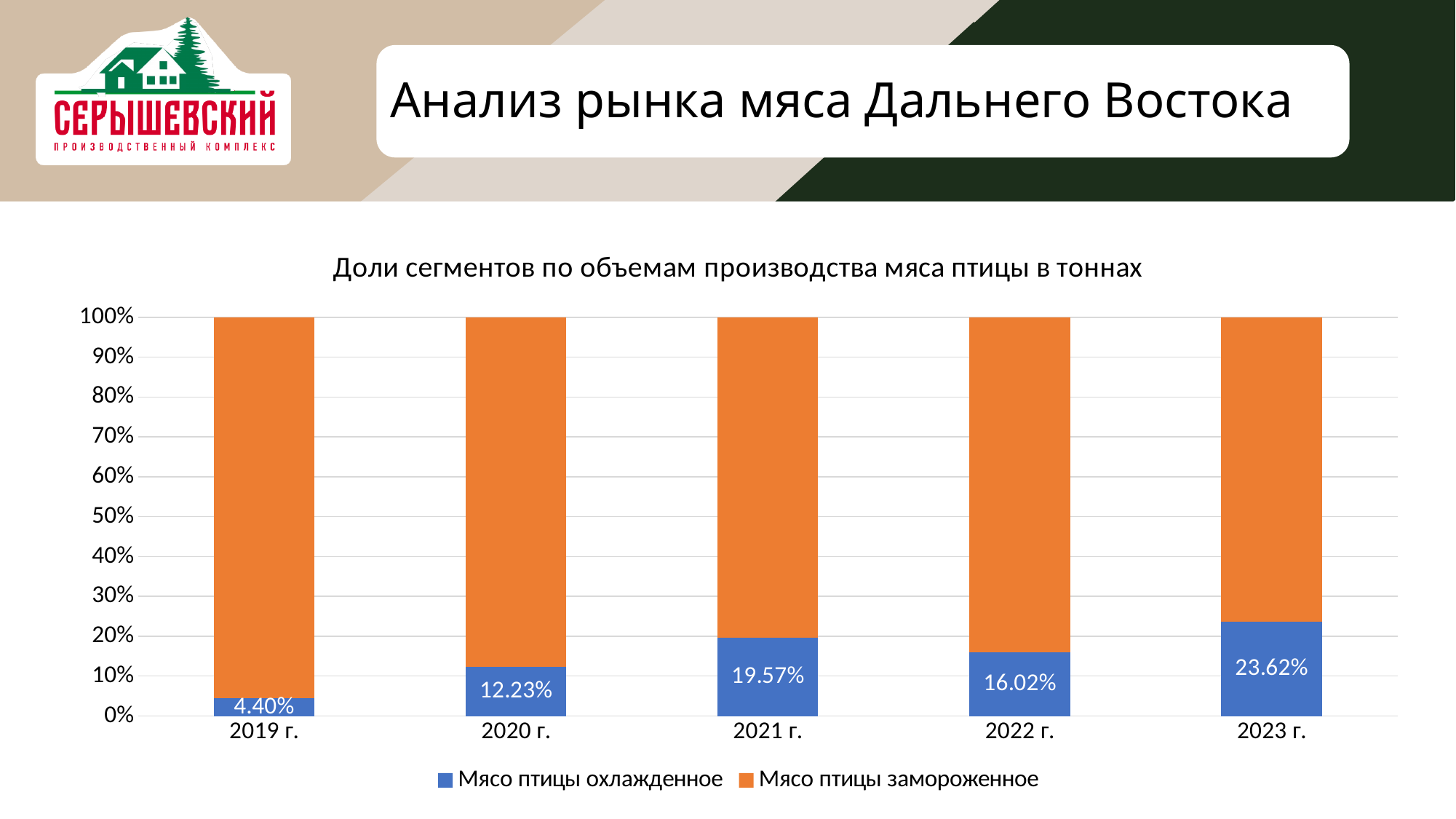
In which year is the share of chilled poultry meat (Мясо птицы охлажденное) the highest? 2023 г. In which year is the share of chilled poultry meat (Мясо птицы охлажденное) the lowest? 2019 г. What is the share of chilled poultry meat (Мясо птицы охлажденное) in 2021 г.? 19.57% What is the title of the chart? Доли сегментов по объемам производства мяса птицы в тоннах What is the share of chilled poultry meat (Мясо птицы охлажденное) in 2023 г.? 23.62% What is the share of chilled poultry meat (Мясо птицы охлажденное) in 2019 г.? 4.40% What is the difference between the chilled poultry meat share in 2023 г. and in 2019 г.? 19.22% What kind of chart is shown on the slide? Stacked bar chart Which year has a larger share of chilled poultry meat: 2021 г. or 2022 г.? 2021 г. How many series does the chart legend list? 2 Is the share of frozen poultry meat (Мясо птицы замороженное) in 2023 г. greater or less than 70%? greater How many years are shown on the x axis of the chart? 5